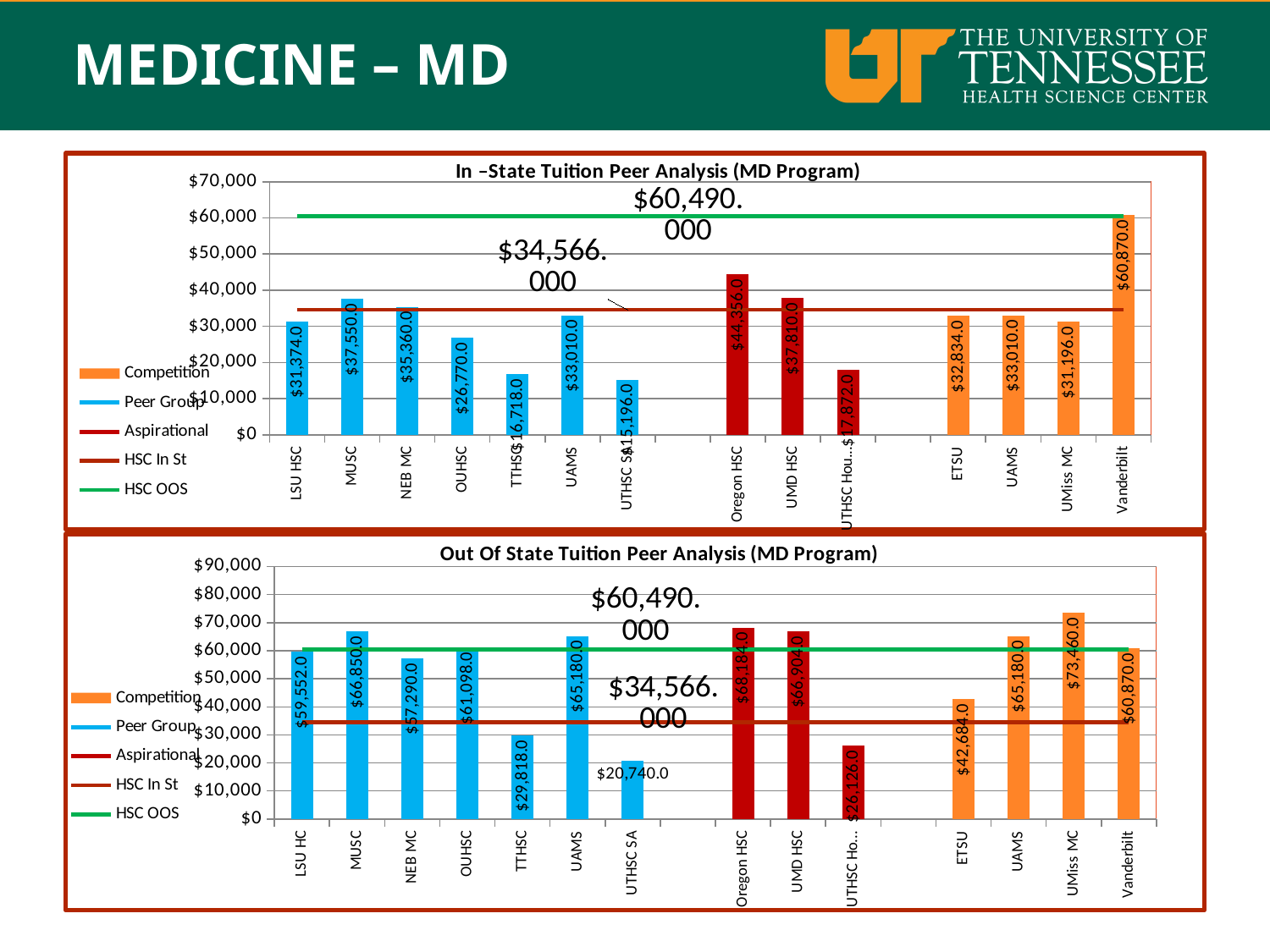
In the Out Of State Tuition Peer Analysis chart, what is the difference between MUSC and NEB MC? $9,560.0 In the In-State Tuition Peer Analysis chart, what is the difference between Oregon HSC and UMD HSC? $6,546.0 In the Out Of State Tuition Peer Analysis chart, which institution has the highest bar? UMiss MC How many entries does the legend of the Out Of State Tuition Peer Analysis chart list? 5 In the In-State Tuition Peer Analysis chart, which is larger, NEB MC or LSU HSC? NEB MC In the In-State Tuition Peer Analysis chart, what is the value for MUSC? $37,550.0 In the Out Of State Tuition Peer Analysis chart, which institution has the lowest bar? UTHSC SA How many bars are plotted in the In-State Tuition Peer Analysis chart? 14 In the In-State Tuition Peer Analysis chart, which institution has the lowest bar? UTHSC SA In the Out Of State Tuition Peer Analysis chart, what is the value for ETSU? $42,684.0 What kind of chart is the In-State Tuition Peer Analysis (MD Program) chart? bar chart In the In-State Tuition Peer Analysis chart, which institution has the highest bar? Vanderbilt